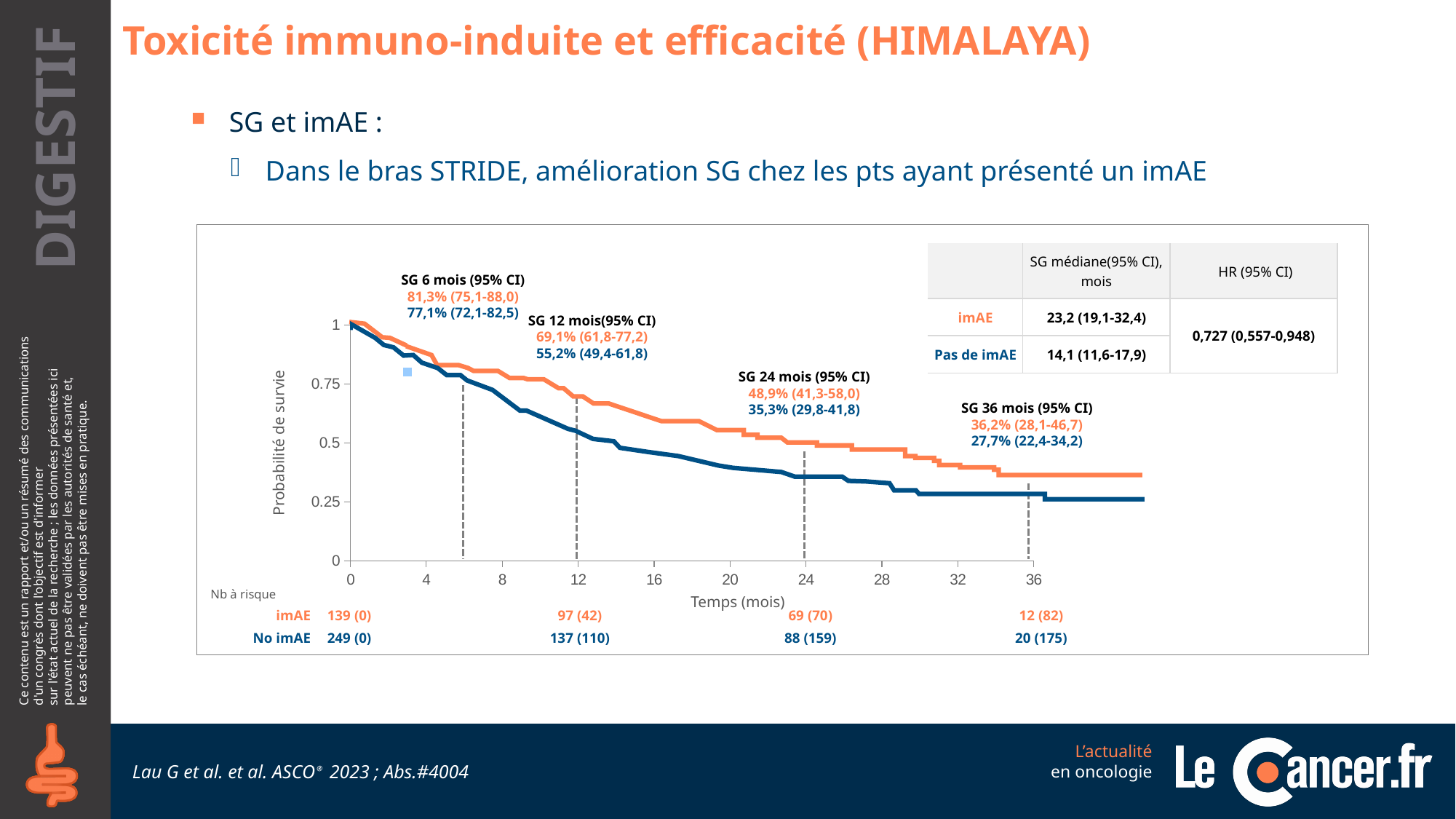
What is the 6-month survival (SG 6 mois) for the imAE group? 81,3% (75,1-88,0) Do the survival probabilities rise or fall along the x axis (Temps, mois)? fall What is the HR (95% CI) shown in the table? 0,727 (0,557-0,948) Which group has the higher 24-month survival, imAE or No imAE? imAE What is the difference in 36-month survival percentage between the imAE and No imAE groups? 8,5% How many patients were at risk in the No imAE group at time 0? 249 (0) What is the 12-month survival (SG 12 mois) for the No imAE group? 55,2% (49,4-61,8) What is the 36-month survival (SG 36 mois) for the No imAE group? 27,7% (22,4-34,2) How many series (groups) are plotted on the chart? 2 What is the 24-month survival (SG 24 mois) for the imAE group? 48,9% (41,3-58,0) What kind of chart is shown on the slide? Kaplan-Meier survival curve (line chart) What is the median SG (in months) for the imAE group according to the table? 23,2 (19,1-32,4)